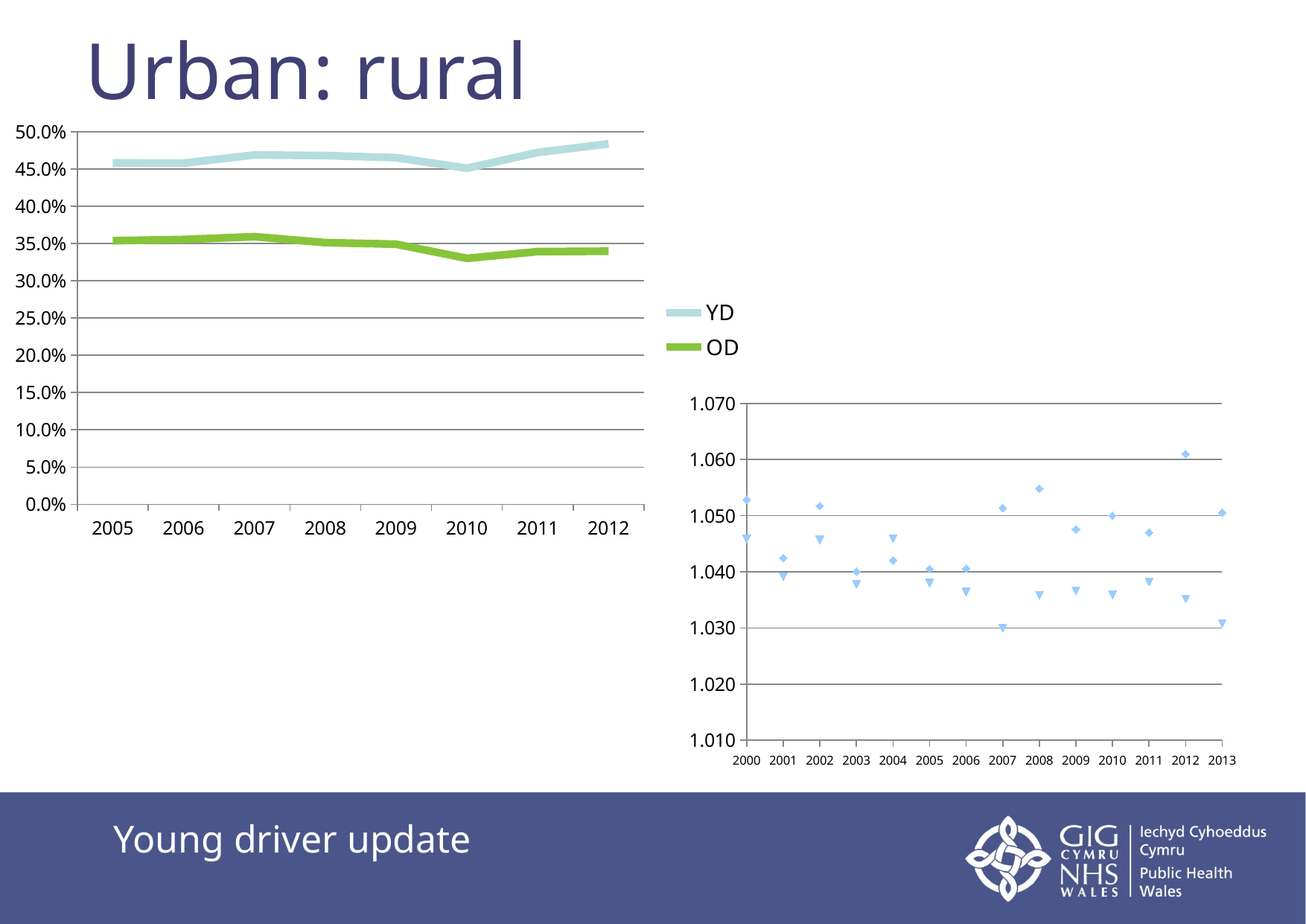
In the left-hand chart, which series has the larger value in 2012, YD or OD? YD In the left-hand chart, is the OD value for 2010 greater or less than 35.0%? less How many years are shown on the x axis of the right-hand scatter chart? 14 In the left-hand chart, which year has the lowest OD value? 2010 In the left-hand chart, which year has the highest YD value? 2012 In the left-hand chart, is the YD value for 2010 greater or less than 40.0%? greater How many series does the legend of the left-hand chart list? 2 What are the two series named in the legend of the left-hand chart? YD and OD What kind of chart is the left-hand chart on the slide? line chart In the right-hand scatter chart, is the diamond marker for 2012 greater or less than 1.050? greater How many years are shown on the x axis of the left-hand chart? 8 In the left-hand chart, which year has the lowest YD value? 2010